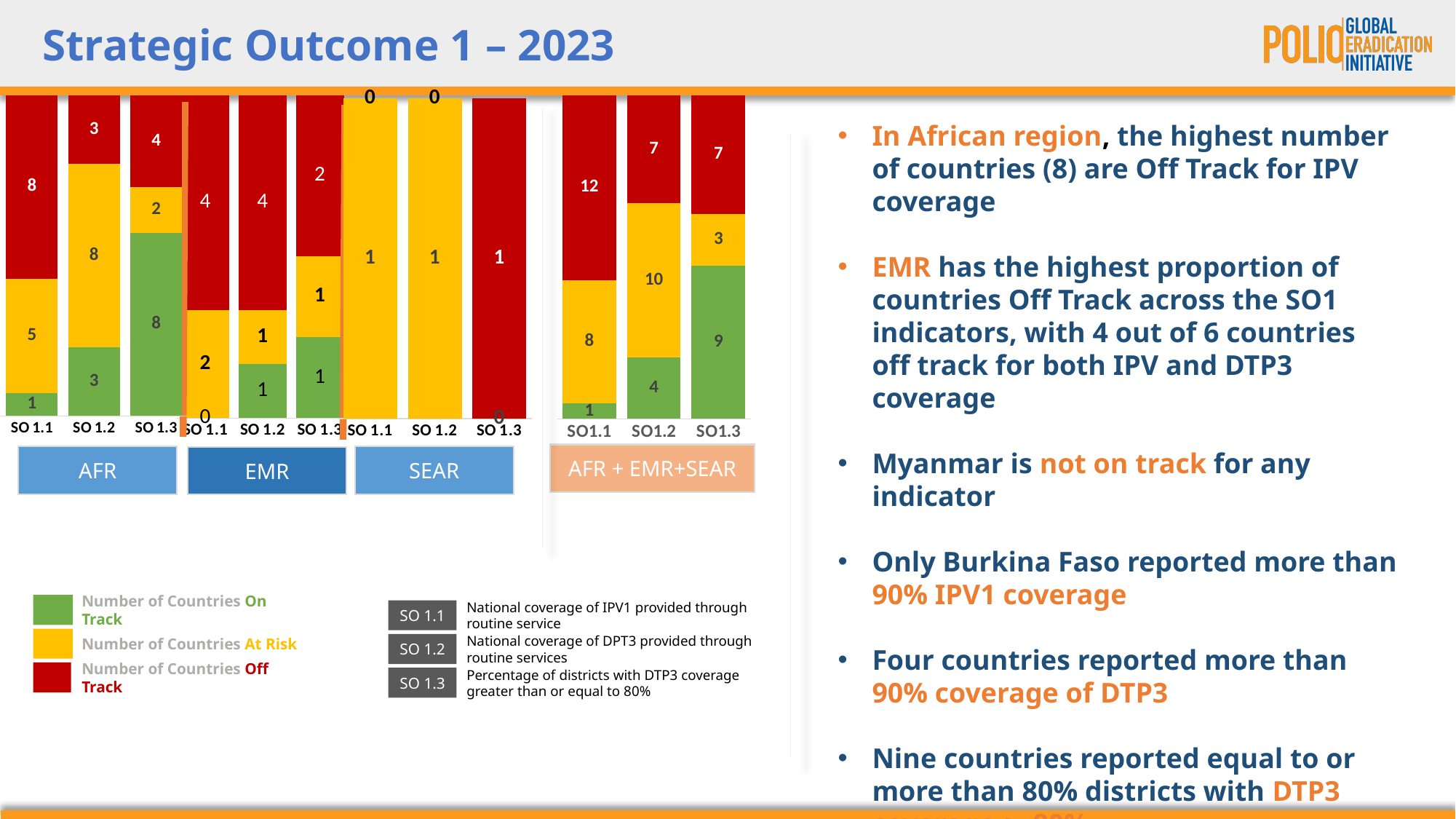
In the AFR + EMR+SEAR chart, how many countries are On Track for SO1.3? 9 In the AFR chart, how many countries are On Track for SO 1.3? 8 In the AFR + EMR+SEAR chart, which indicator has the highest number of Off Track countries? SO1.1 What type of chart is used to show the number of countries per indicator? Stacked bar chart In the AFR chart, which is larger: the On Track count for SO 1.3 or the On Track count for SO 1.2? SO 1.3 In the AFR chart, how many countries are At Risk for SO 1.2? 8 In the AFR + EMR+SEAR chart, how many countries are At Risk for SO1.2? 10 In the EMR chart, how many countries are Off Track for SO 1.1? 4 In the AFR + EMR+SEAR chart, what is the difference between the Off Track counts for SO1.1 and SO1.2? 5 In the AFR chart, how many countries are Off Track for SO 1.1? 8 In the AFR chart, what is the total number of countries in the SO 1.1 stacked bar? 14 How many series does the legend list for the charts? 3